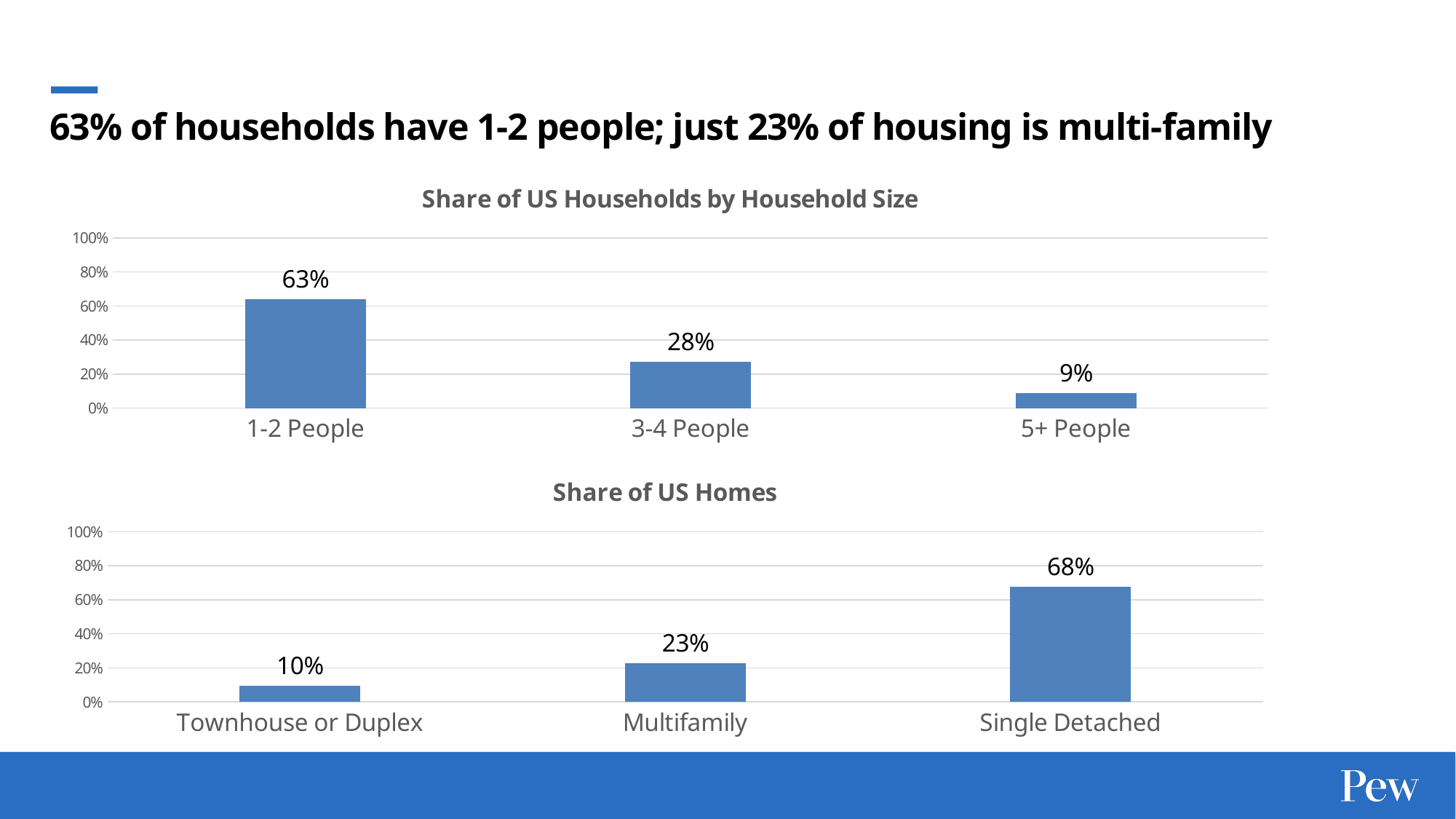
In the 'Share of US Homes' chart, which is larger, the value for Multifamily or the value for Townhouse or Duplex? Multifamily In the 'Share of US Households by Household Size' chart, do the values rise or fall from left to right along the x axis? fall In the 'Share of US Households by Household Size' chart, what is the value for 3-4 People? 28% In the 'Share of US Homes' chart, what is the value for Townhouse or Duplex? 10% In the 'Share of US Households by Household Size' chart, what is the difference between the values for 1-2 People and 3-4 People? 35% In the 'Share of US Homes' chart, what is the difference between the values for Single Detached and Multifamily? 45% In the 'Share of US Households by Household Size' chart, what is the value for 1-2 People? 63% What kind of chart is the 'Share of US Households by Household Size' chart? bar chart In the 'Share of US Homes' chart, which category has the highest value? Single Detached In the 'Share of US Households by Household Size' chart, which category has the lowest value? 5+ People In the 'Share of US Homes' chart, what is the value for Multifamily? 23% How many categories are shown in the 'Share of US Homes' chart? 3